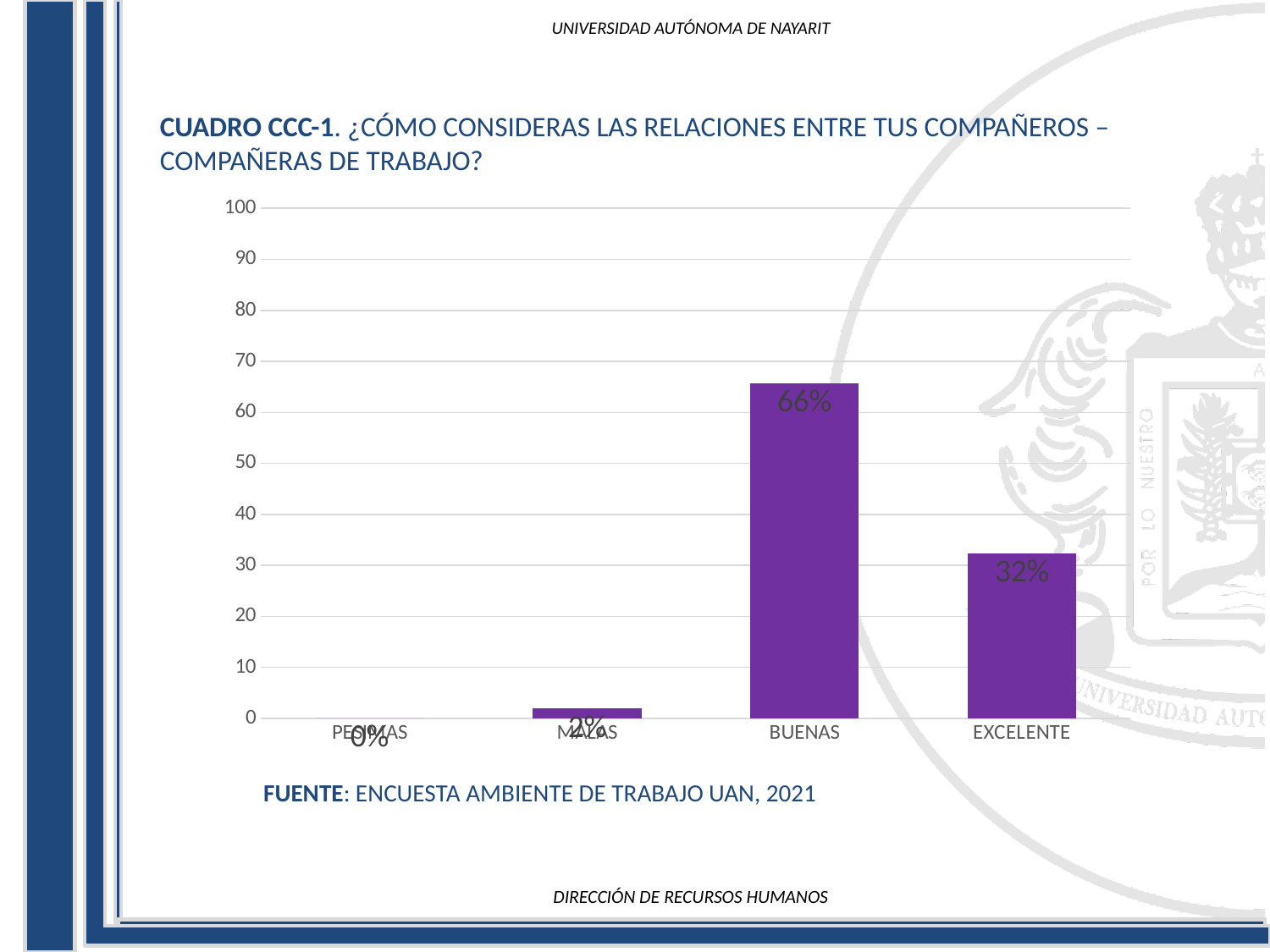
Which is larger, the value for EXCELENTE or the value for MALAS? EXCELENTE Which category has the lowest value? PÉSIMAS What is the value for PÉSIMAS? 0% How many categories are shown on the x axis? 4 What is the difference between the values for BUENAS and EXCELENTE? 34% What kind of chart is shown on the slide? bar chart Is the value for BUENAS greater or less than 60? greater Which category has the highest value? BUENAS What source is cited below the chart? ENCUESTA AMBIENTE DE TRABAJO UAN, 2021 What is the value for MALAS? 2% What is the value for BUENAS? 66% What is the value for EXCELENTE? 32%